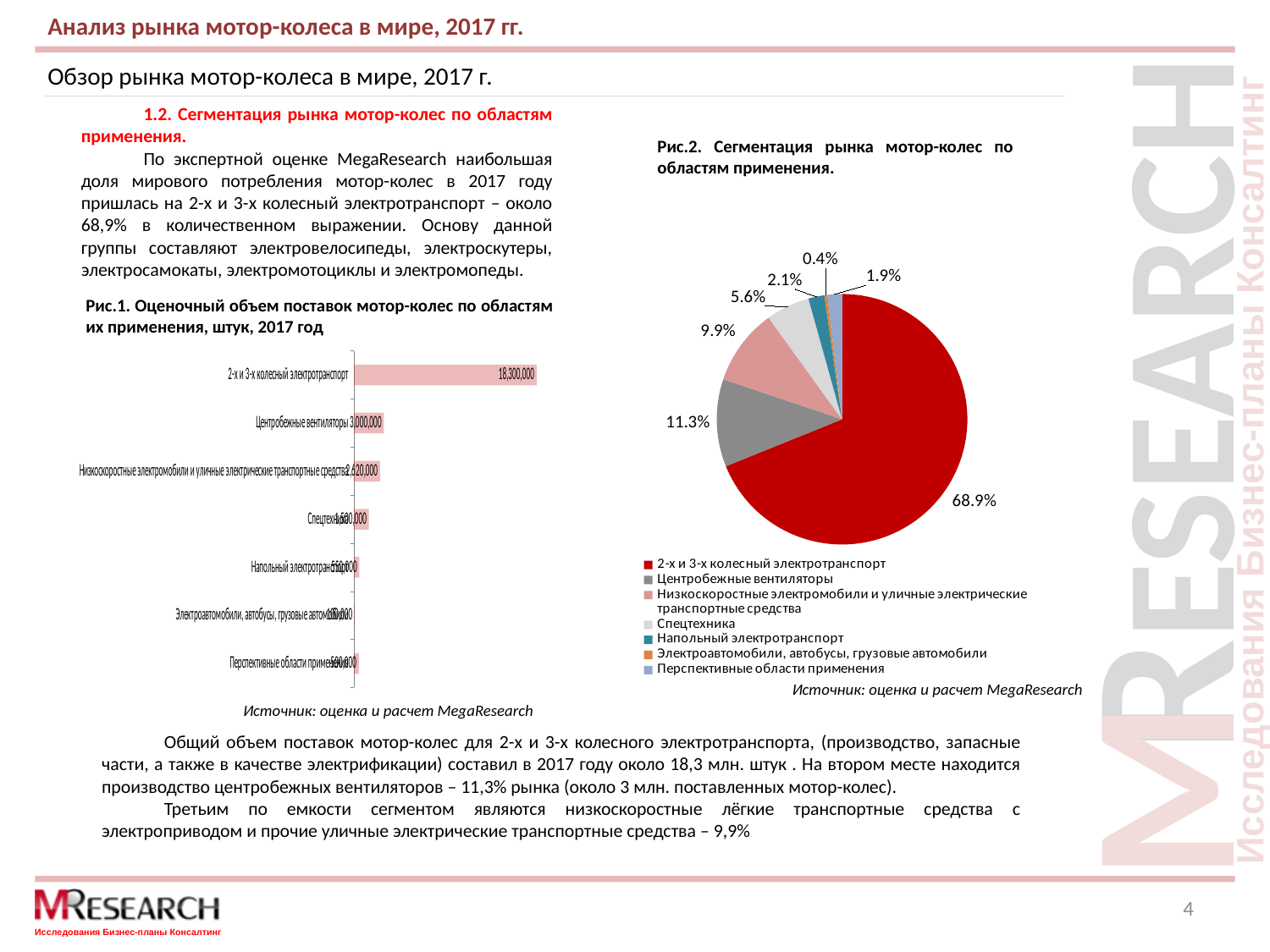
In the pie chart (Рис.2), what share is shown for Центробежные вентиляторы? 11.3% In the pie chart (Рис.2), what is the difference in percentage points between the shares of 2-х и 3-х колесный электротранспорт and Центробежные вентиляторы? 57.6 percentage points What kind of chart is Рис.1? Bar chart What kind of chart is Рис.2? Pie chart In the pie chart (Рис.2), what share is shown for 2-х и 3-х колесный электротранспорт? 68.9% In the bar chart (Рис.1), what is the value for Центробежные вентиляторы? 3,000,000 In the bar chart (Рис.1), what is the value for 2-х и 3-х колесный электротранспорт? 18,300,000 In the pie chart (Рис.2), what share is shown for Спецтехника? 5.6% In the pie chart (Рис.2), which category has the smallest slice? Электроавтомобили, автобусы, грузовые автомобили In the bar chart (Рис.1), what is the difference between the values for 2-х и 3-х колесный электротранспорт and Центробежные вентиляторы? 15,300,000 How many entries does the legend of the pie chart (Рис.2) list? 7 How many categories are shown in the bar chart (Рис.1)? 7